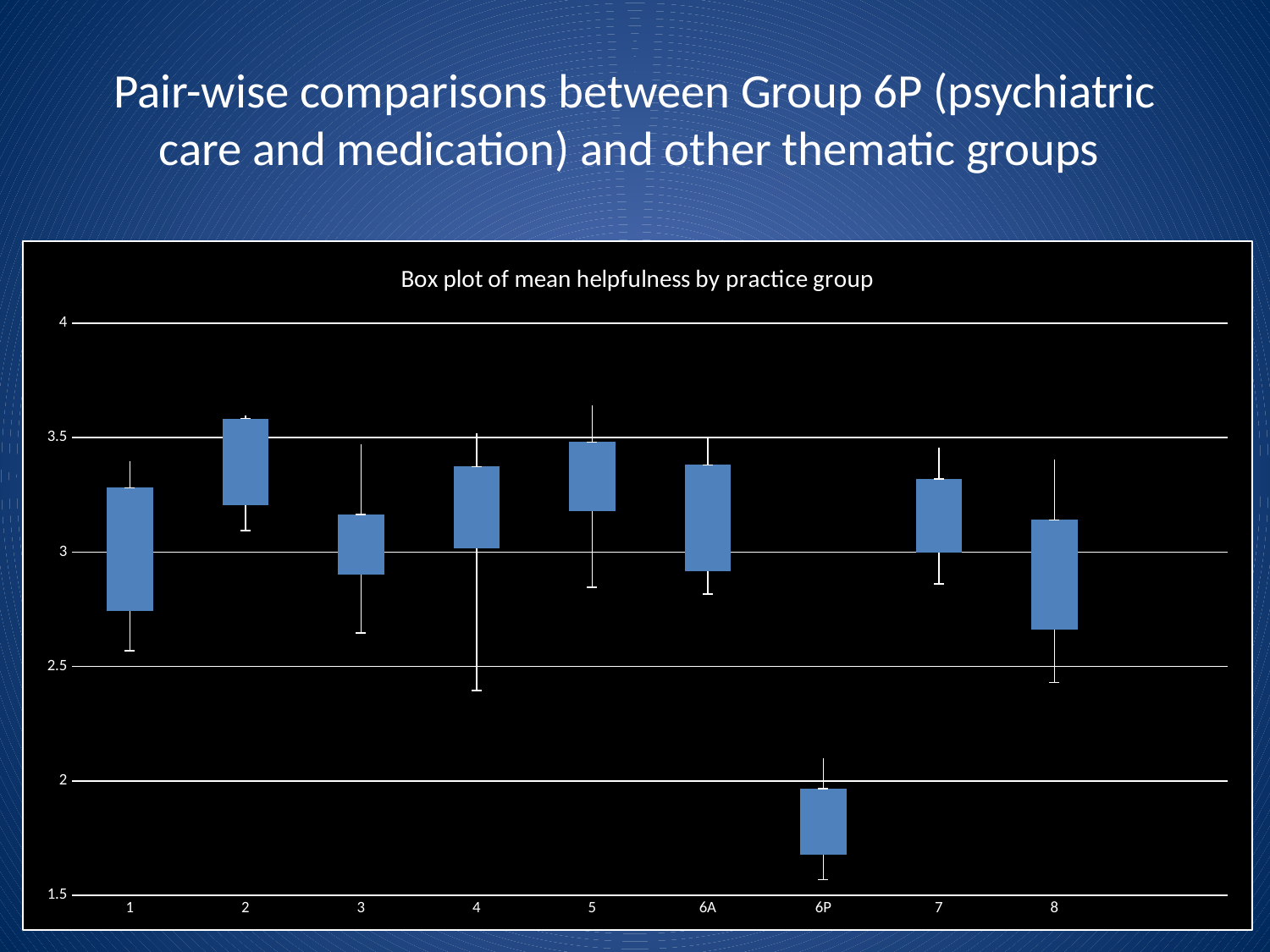
Is the box for group 6A greater or less than 2.5? greater Is the box for group 2 greater or less than 3? greater Which group's box is higher on the chart, 6P or 7? 7 Is the box for group 6P greater or less than 2? less Which practice group has the lowest box on the chart? 6P What kind of chart is shown on the slide? Box plot What is the title of the chart? Box plot of mean helpfulness by practice group What is the lowest value shown on the y axis of the chart? 1.5 How many practice groups are shown on the x axis of the chart? 9 Which practice group has the highest box on the chart? 2